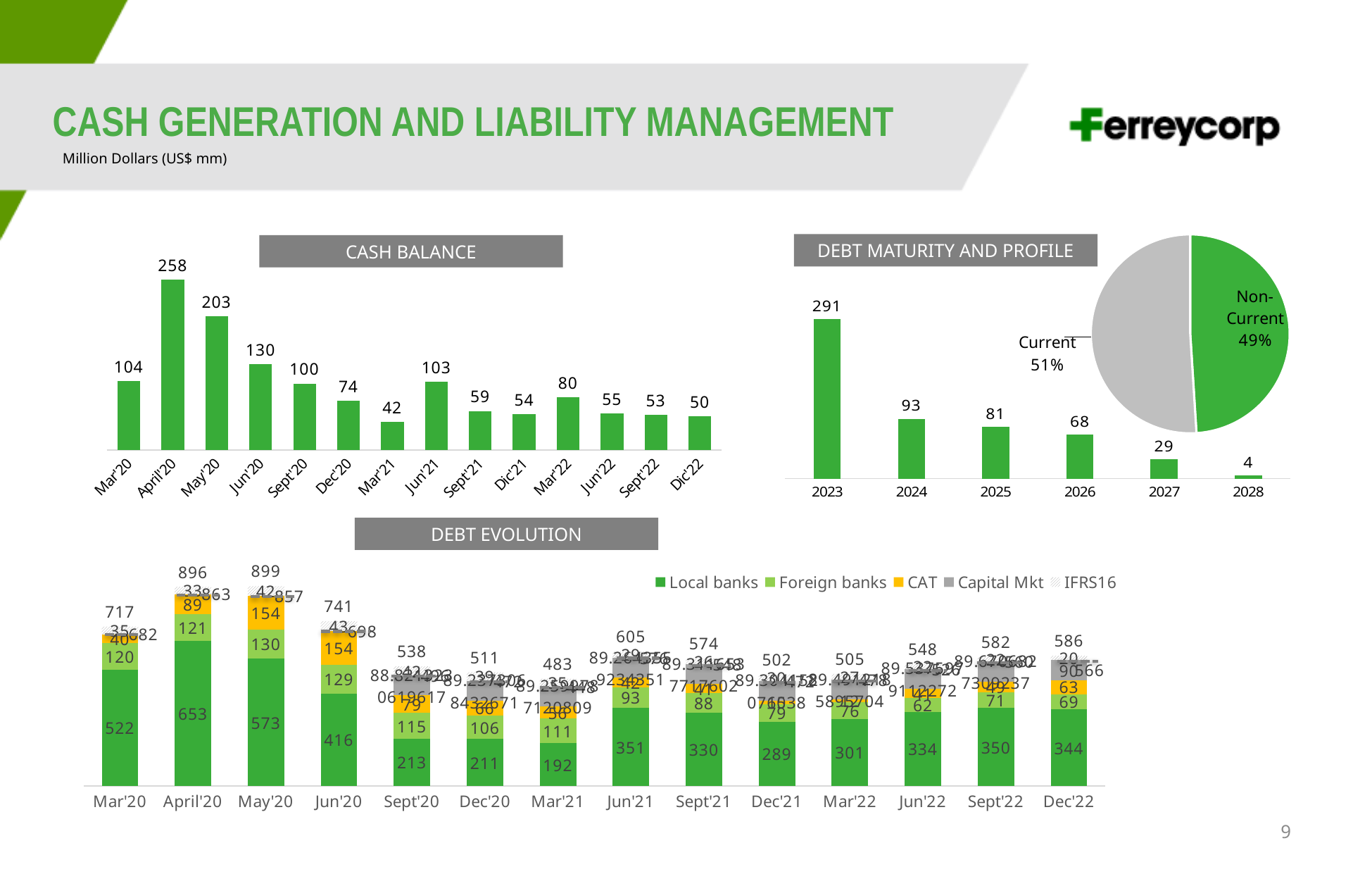
In the Cash Balance chart, how many periods are shown on the x axis? 14 In the Debt Maturity and Profile chart, what is the debt maturing in 2023? 291 In the Cash Balance chart, what is the difference between the cash balance in May'20 and Jun'20? 73 What kind of chart is the Debt Evolution chart? Stacked bar chart In the Cash Balance chart, what is the cash balance for April'20? 258 In the Debt Evolution chart, what is the total debt for May'20? 899 In the Debt Maturity and Profile chart, which year has the lowest debt maturity? 2028 In the Cash Balance chart, which period has the lowest cash balance? Mar'21 In the Debt Evolution chart, how many series does the legend list? 5 In the Debt Maturity and Profile chart, is the value for 2025 larger or the value for 2026? 2025 In the Debt Maturity and Profile pie chart, what share of debt is Current? 51% In the Debt Evolution chart, what is the Local banks value for Dec'22? 344